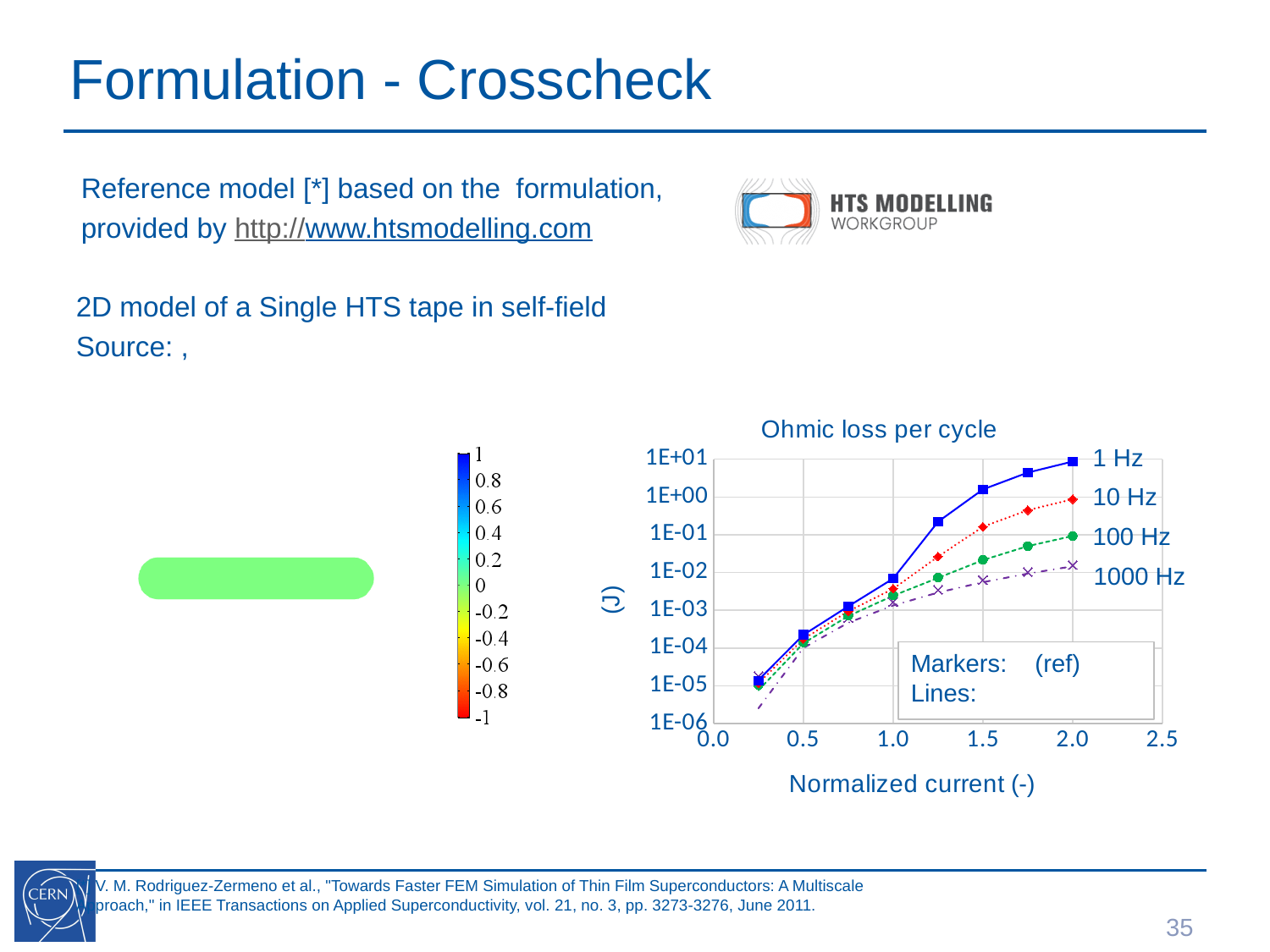
At a normalized current of 2.0, is the ohmic loss for 1 Hz or for 1000 Hz larger? 1 Hz How many series are labelled on the Ohmic loss per cycle chart? 4 What is the title of the chart on the slide? Ohmic loss per cycle How many data points are plotted for the 1 Hz series? 8 Which series has the highest ohmic loss at a normalized current of 2.0? 1 Hz Does the ohmic loss for the 1 Hz series rise or fall as the normalized current increases? rise What is the label of the x axis of the Ohmic loss per cycle chart? Normalized current (-) Is the ohmic loss for 1000 Hz at a normalized current of 2.0 greater or less than 1E-01? less At a normalized current of 2.0, is the ohmic loss for 10 Hz or for 100 Hz larger? 10 Hz What kind of chart is shown under the title "Ohmic loss per cycle"? line chart Is the ohmic loss for 1 Hz at a normalized current of 2.0 greater or less than 1E+00? greater Which series has the lowest ohmic loss at a normalized current of 2.0? 1000 Hz